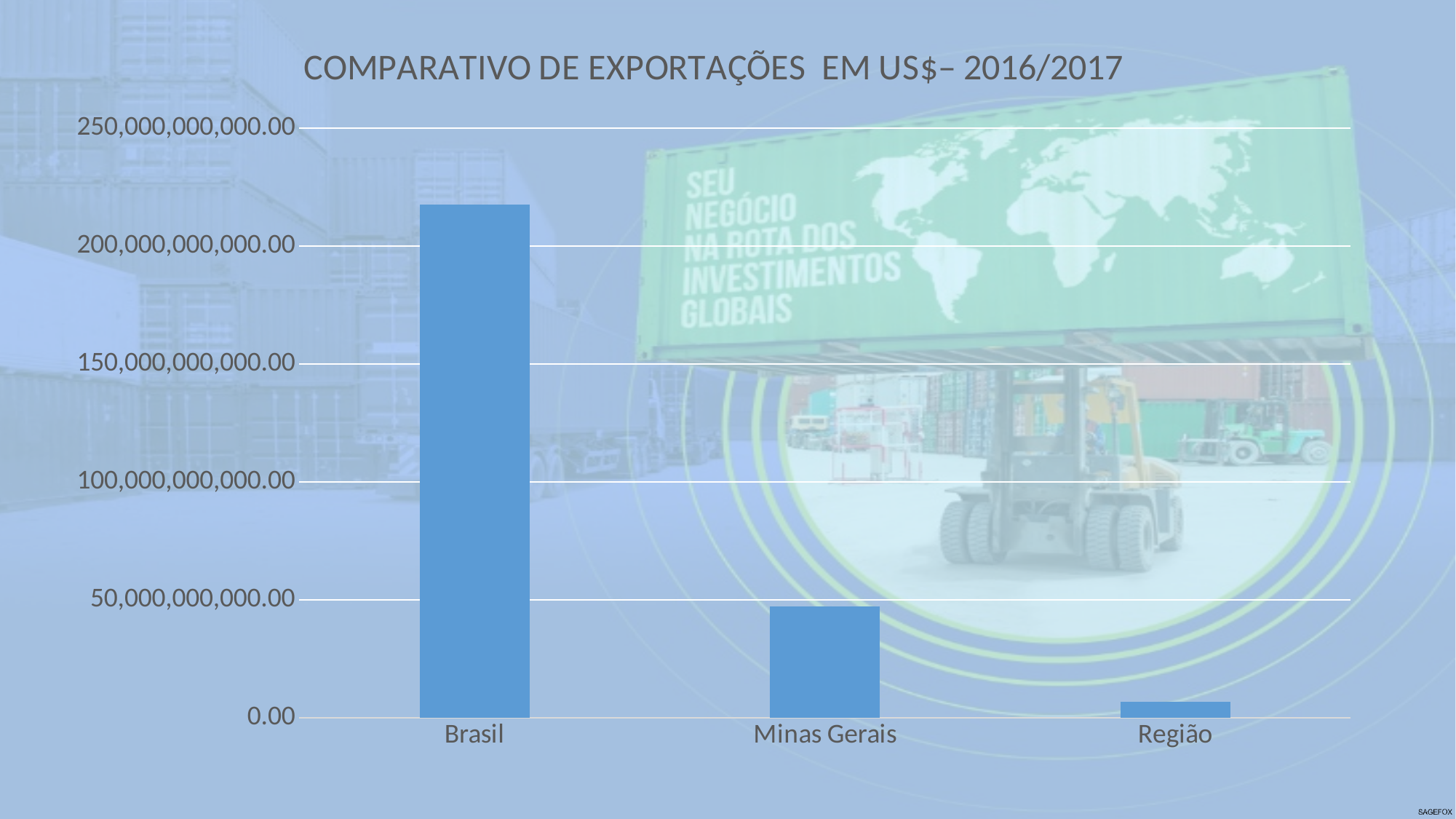
Do the values rise or fall from left to right along the x axis? fall Is the value for Brasil greater or less than 250,000,000,000.00? less What is the title of the chart? COMPARATIVO DE EXPORTAÇÕES EM US$– 2016/2017 Which category has the lowest value? Região Which category has the highest value? Brasil What type of chart is shown on the slide? bar chart What is the highest value labelled on the vertical axis? 250,000,000,000.00 Is the value for Região greater or less than 50,000,000,000.00? less How many categories are shown on the x axis? 3 Is the value for Brasil greater or less than 200,000,000,000.00? greater Which is larger, the value for Minas Gerais or the value for Região? Minas Gerais